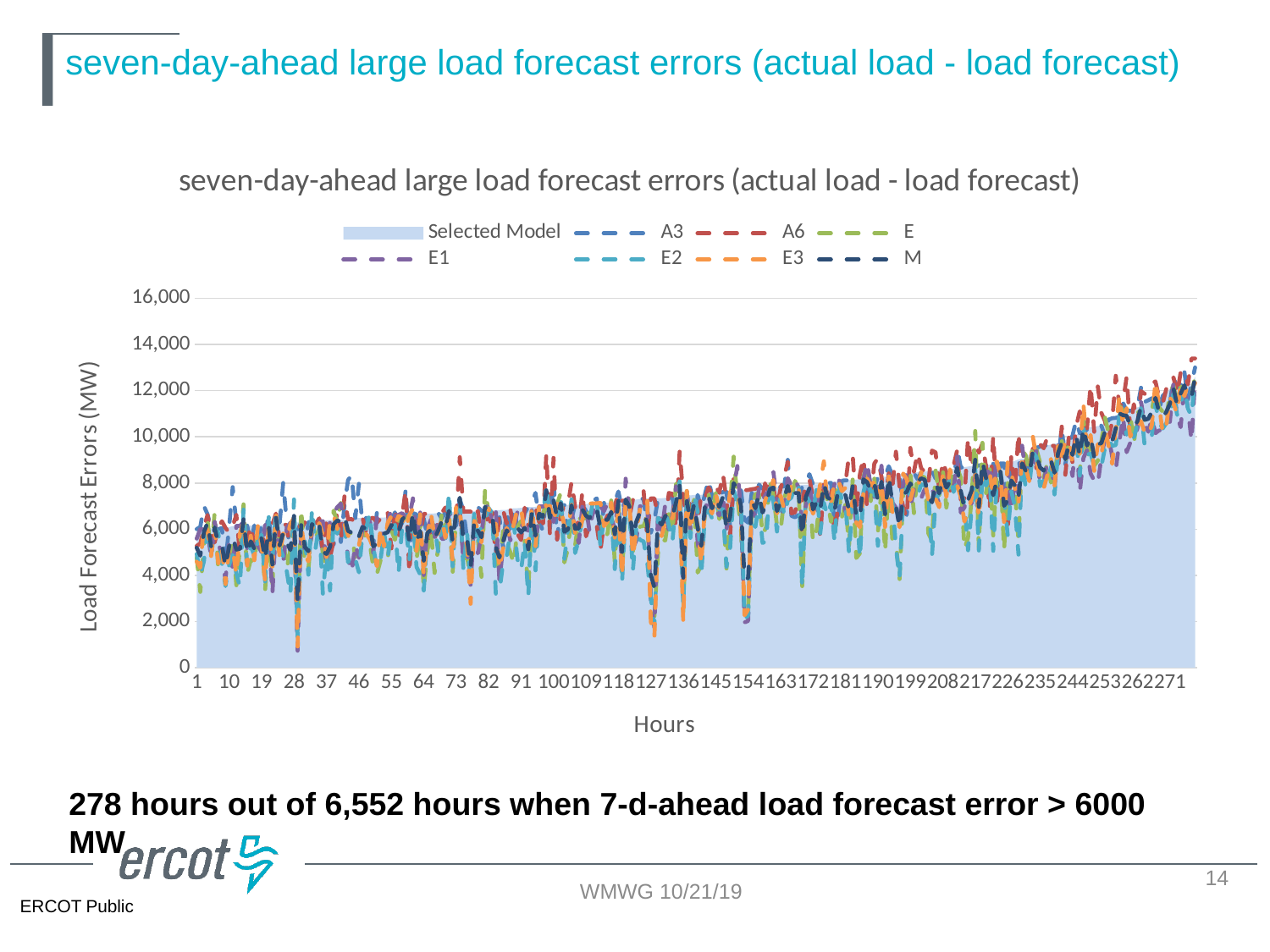
Overall, do the plotted values rise or fall as the hours increase along the x axis? rise Is the Selected Model value at hour 1 greater or less than 8,000? less Is the lowest value plotted on the chart greater or less than 2,000? less Is the Selected Model value at hour 100 greater or less than 4,000? greater Which series is drawn as a shaded area rather than a dashed line? Selected Model What is the title of the chart? seven-day-ahead large load forecast errors (actual load - load forecast) What kind of chart is shown on the slide? line chart How many series does the legend list? 8